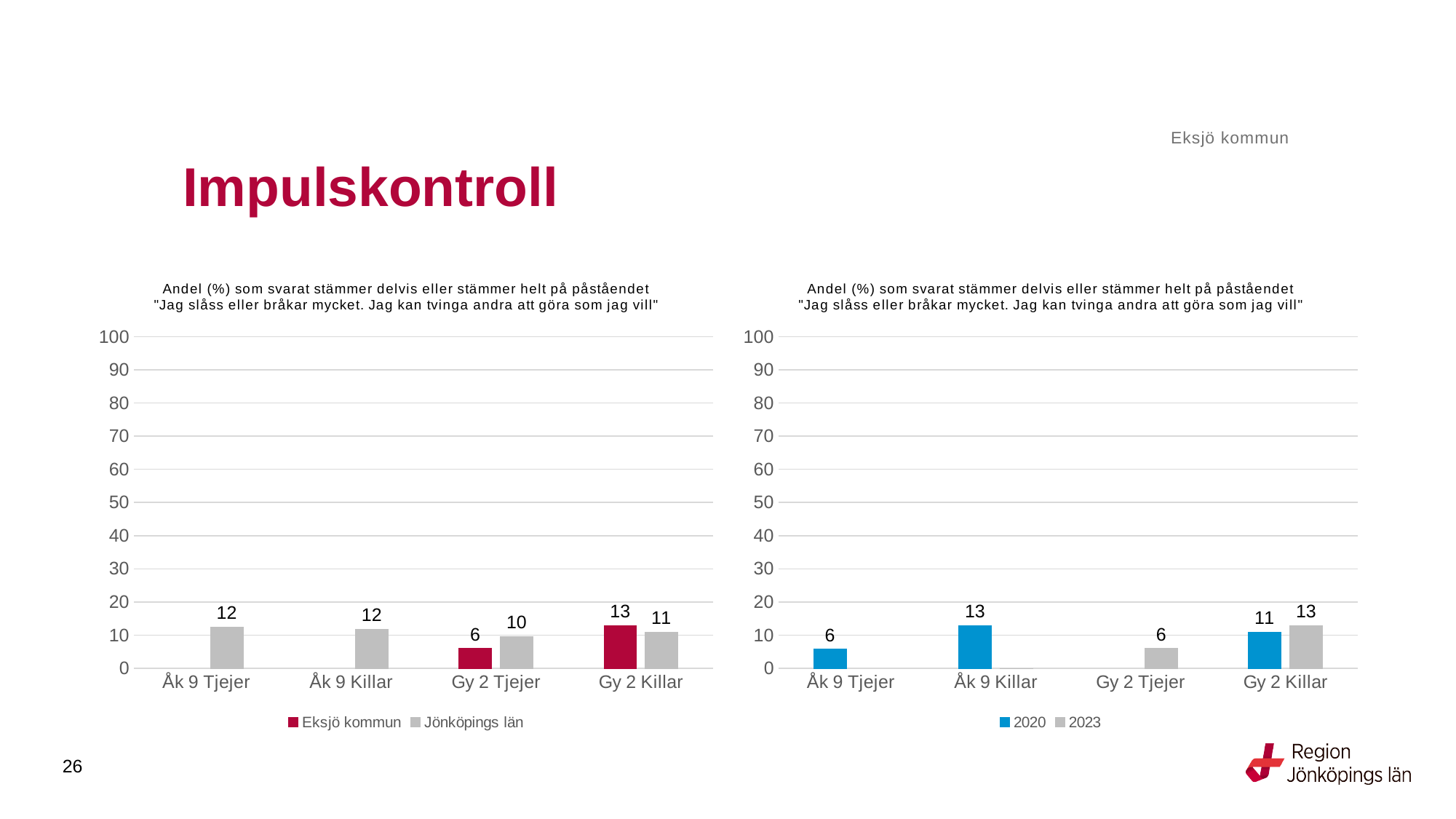
How many categories are shown on the x axis of the right chart? 4 In the left chart, how many series does the legend list? 2 What type of chart is the left chart? Bar chart In the left chart, which category has the lowest Jönköpings län value? Gy 2 Tjejer In the right chart, which category has the lowest 2020 value? Åk 9 Tjejer In the right chart, which is larger for Gy 2 Killar, 2020 or 2023? 2023 In the left chart, what is the difference between Eksjö kommun and Jönköpings län for Gy 2 Tjejer? 4 In the right chart, what is the difference between the 2023 and 2020 values for Gy 2 Killar? 2 In the left chart, what is the value for Jönköpings län for Gy 2 Tjejer? 10 In the right chart, what is the 2020 value for Åk 9 Killar? 13 In the right chart, what is the 2023 value for Gy 2 Tjejer? 6 In the left chart, what is the value for Eksjö kommun for Gy 2 Killar? 13